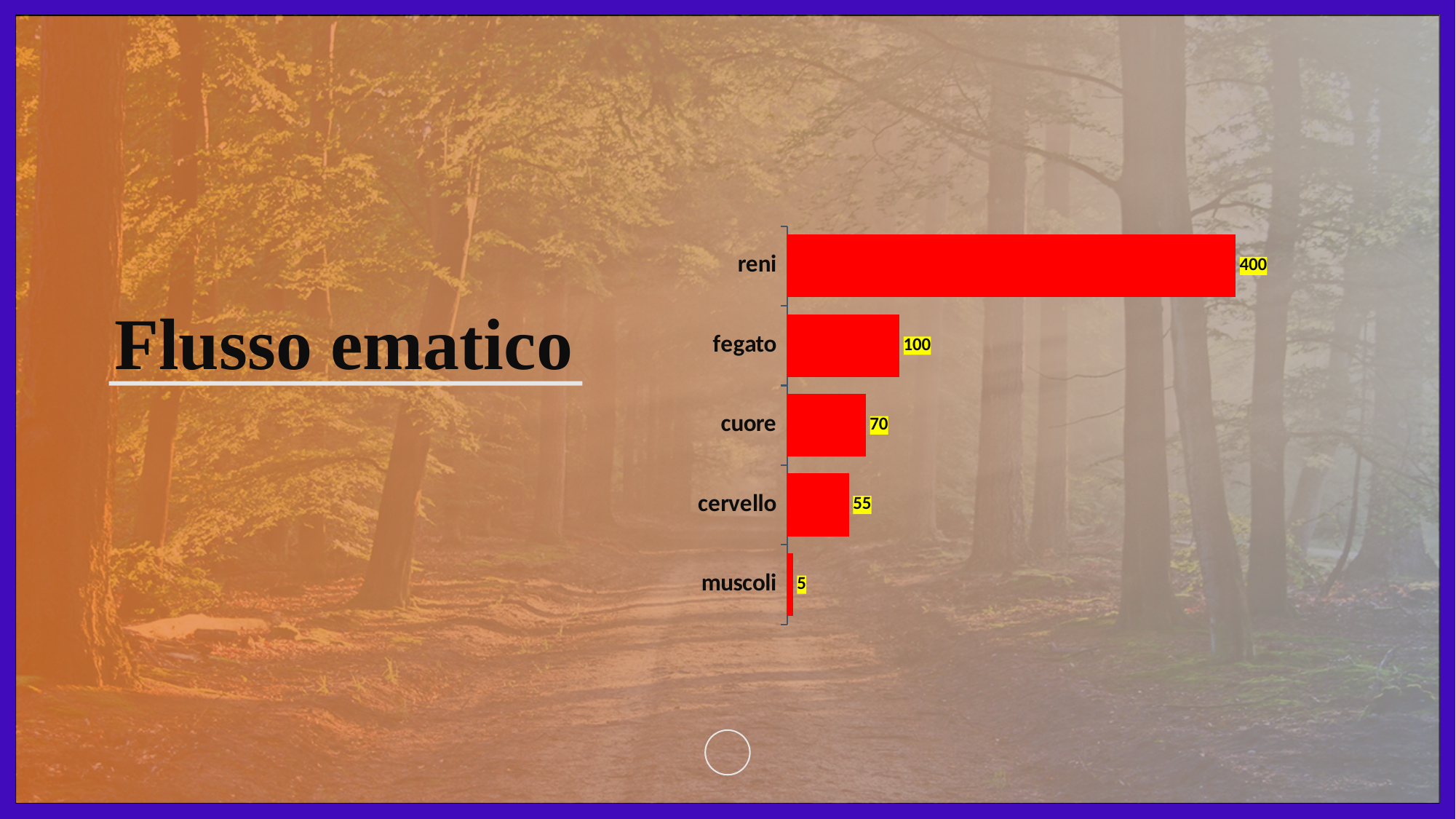
What is the value for muscoli? 5 Which category has the lowest value? muscoli How many categories are shown in the chart? 5 What is the difference between the values for cuore and cervello? 15 What is the value for cervello? 55 What is the difference between the values for reni and fegato? 300 Which category has the highest value? reni Which is larger, the value for fegato or the value for cuore? fegato What is the value for cuore? 70 What kind of chart is shown on the slide? bar chart What is the value for fegato? 100 What is the value for reni? 400